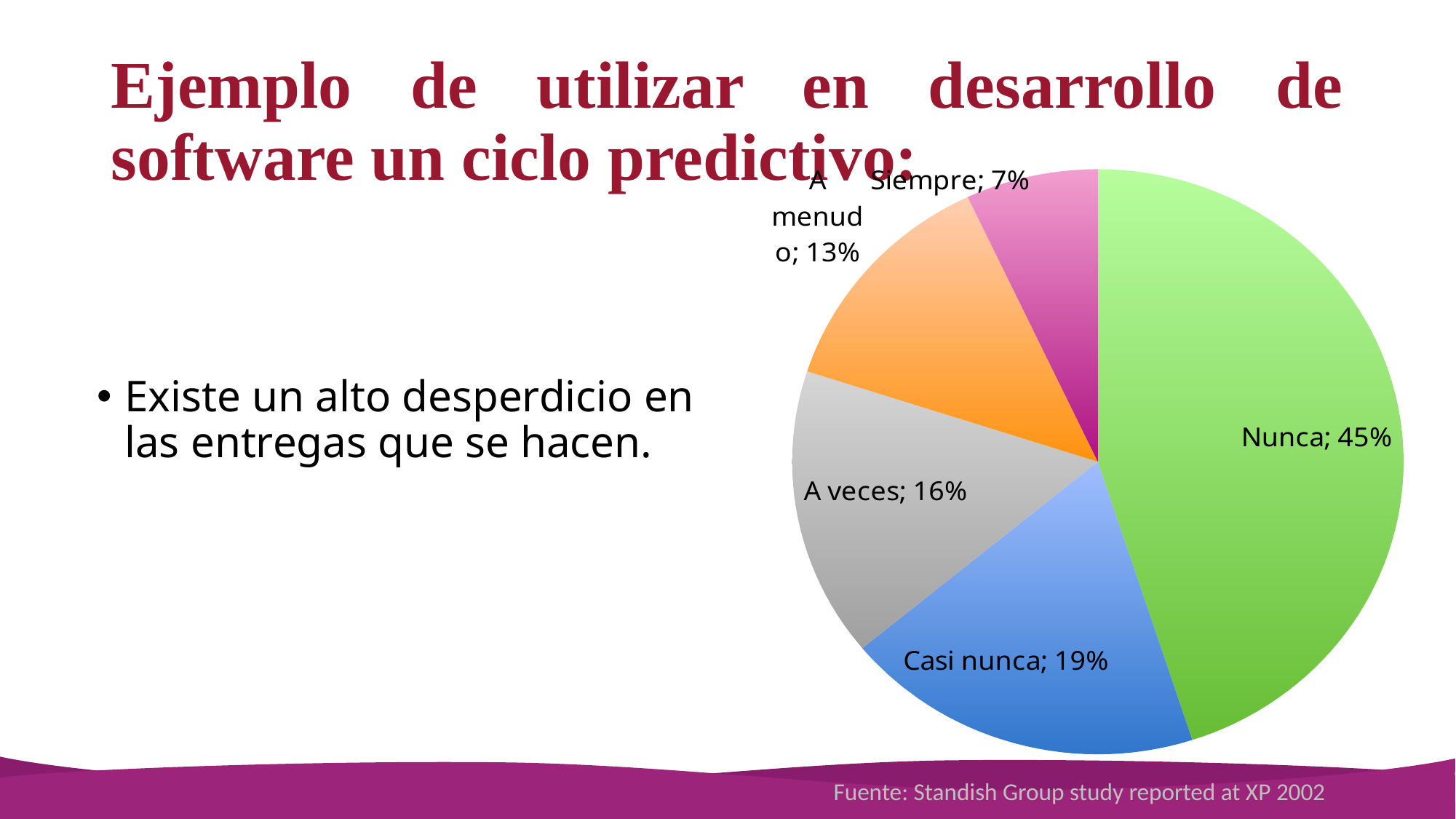
What percentage is shown for the 'A menudo' slice? 13% What percentage is shown for the 'A veces' slice? 16% What percentage is shown for the 'Siempre' slice? 7% How many slices does the pie chart have? 5 What kind of chart is shown on the slide? pie chart Which is larger, the 'A veces' slice or the 'A menudo' slice? A veces What is the difference in percentage points between the 'Nunca' and 'Casi nunca' slices? 26 What percentage is shown for the 'Casi nunca' slice? 19% What colour is the 'Nunca' slice? green Which slice of the pie chart is the smallest? Siempre What percentage is shown for the 'Nunca' slice? 45% Which slice of the pie chart is the largest? Nunca